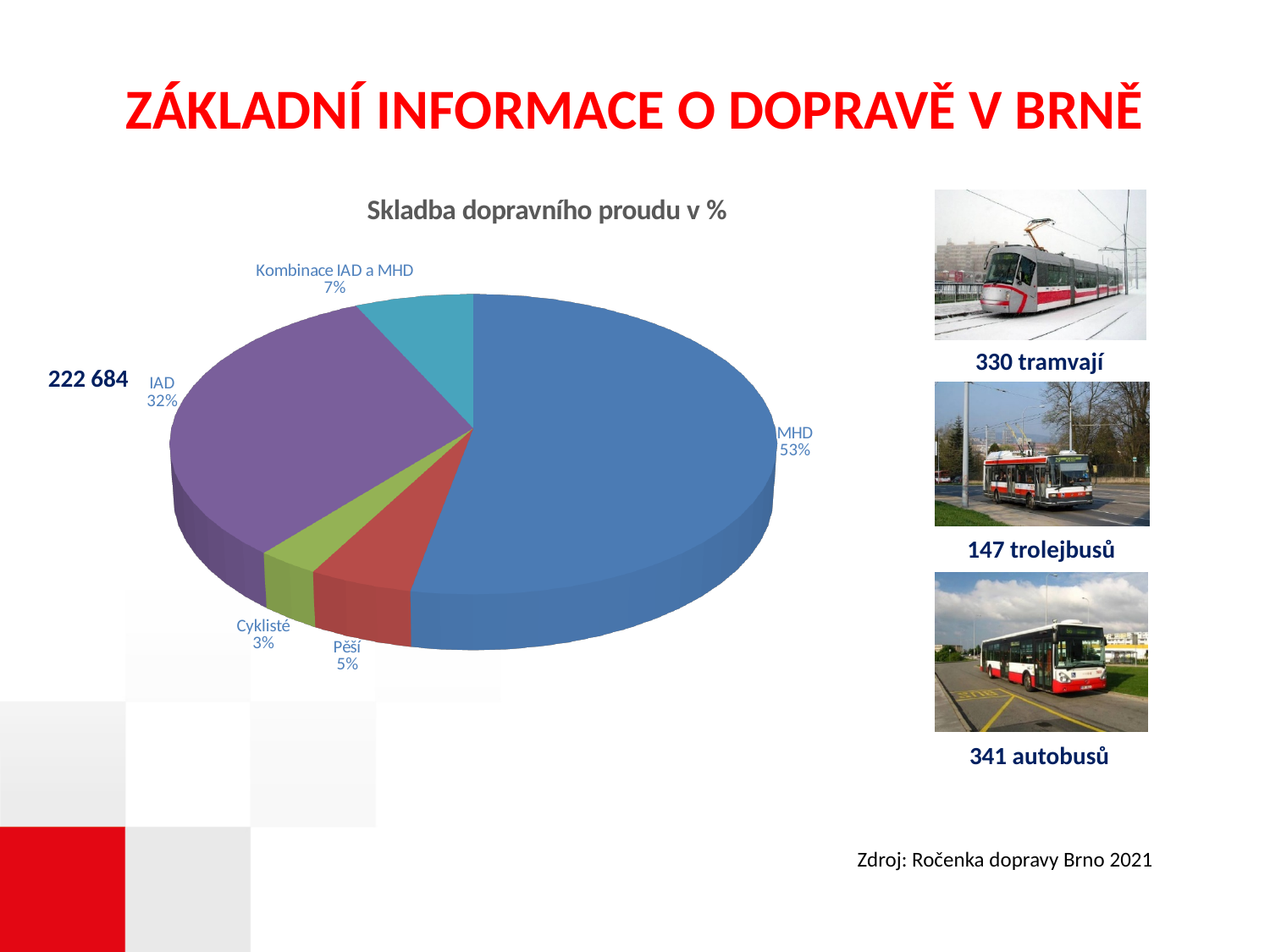
What percentage share does MHD have in the pie chart? 53% What percentage share do Cyklisté have in the pie chart? 3% What percentage share do Pěší have in the pie chart? 5% What percentage share does Kombinace IAD a MHD have in the pie chart? 7% Which has a larger share, Pěší or Kombinace IAD a MHD? Kombinace IAD a MHD What is the difference in percentage points between the MHD share and the IAD share? 21 What percentage share does IAD have in the pie chart? 32% What is the title of the chart? Skladba dopravního proudu v % Which category has the largest share of the pie chart? MHD What type of chart is shown on the slide? pie chart How many categories are shown in the pie chart? 5 Which category has the smallest share of the pie chart? Cyklisté